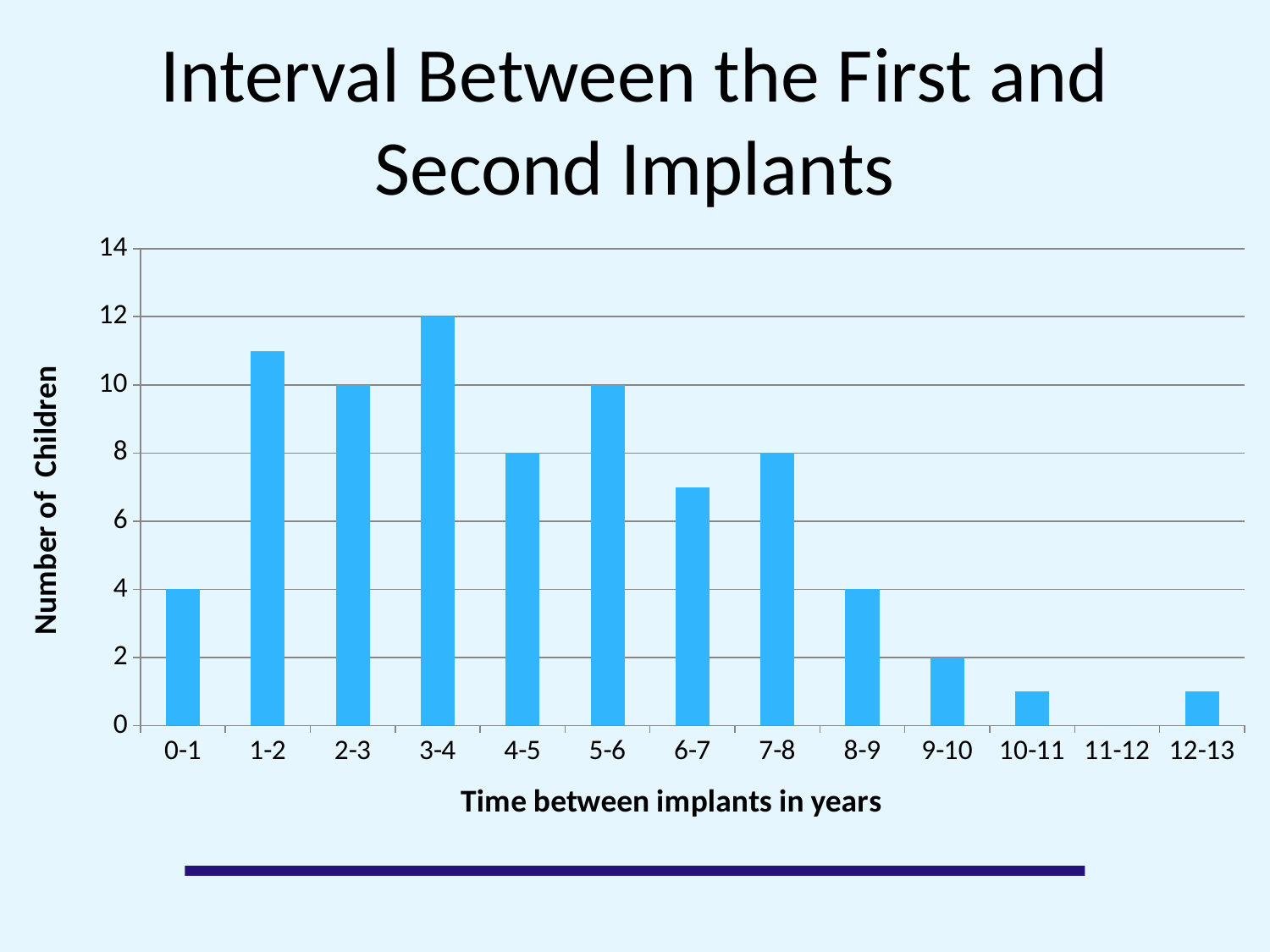
Which interval has more children, 2-3 or 4-5? 2-3 Is the number of children for the 6-7 year interval greater or less than 8? less Is the number of children for the 1-2 year interval greater or less than 10? greater What is the difference in number of children between the 3-4 interval and the 0-1 interval? 8 What is the number of children for the 0-1 year interval? 4 What is the number of children for the 9-10 year interval? 2 Which time interval has the highest number of children? 3-4 What is the label of the y axis? Number of Children Which time interval has the lowest number of children? 11-12 What is the number of children for the 3-4 year interval? 12 How many time-interval categories are shown on the x axis? 13 What type of chart is shown on the slide? Bar chart